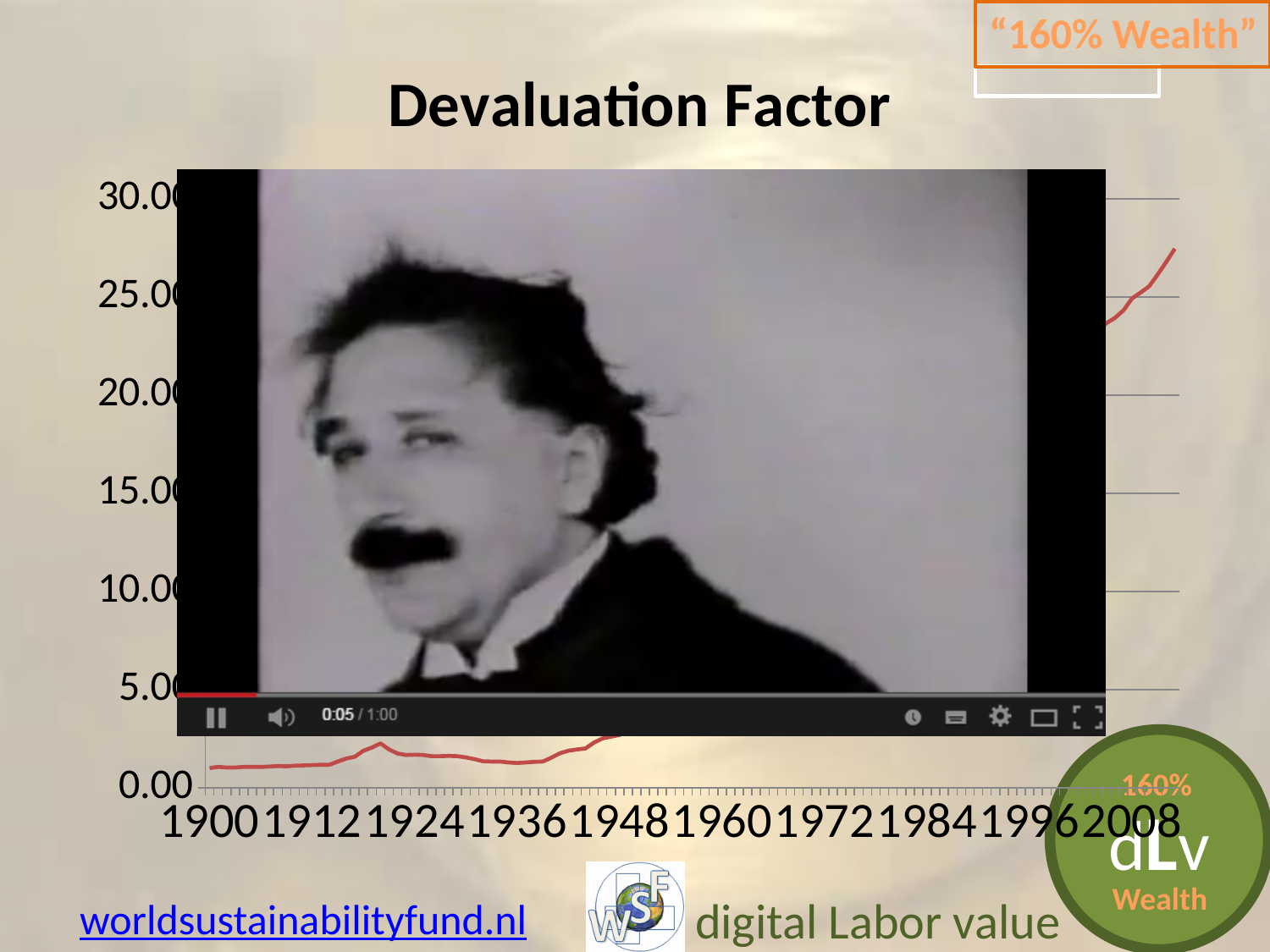
What is the title of the chart? Devaluation Factor Is the value for 1924 greater or less than 5? less Is the value for 1900 greater or less than 5? less What kind of chart is shown on the slide? line chart What is the highest value labelled on the y axis? 30.00 Which is larger, the value for 1900 or the value for 2008? 2008 What is the first year labelled on the x axis? 1900 How many year labels are shown on the x axis? 10 Do the values rise or fall from 1900 to 2008? rise